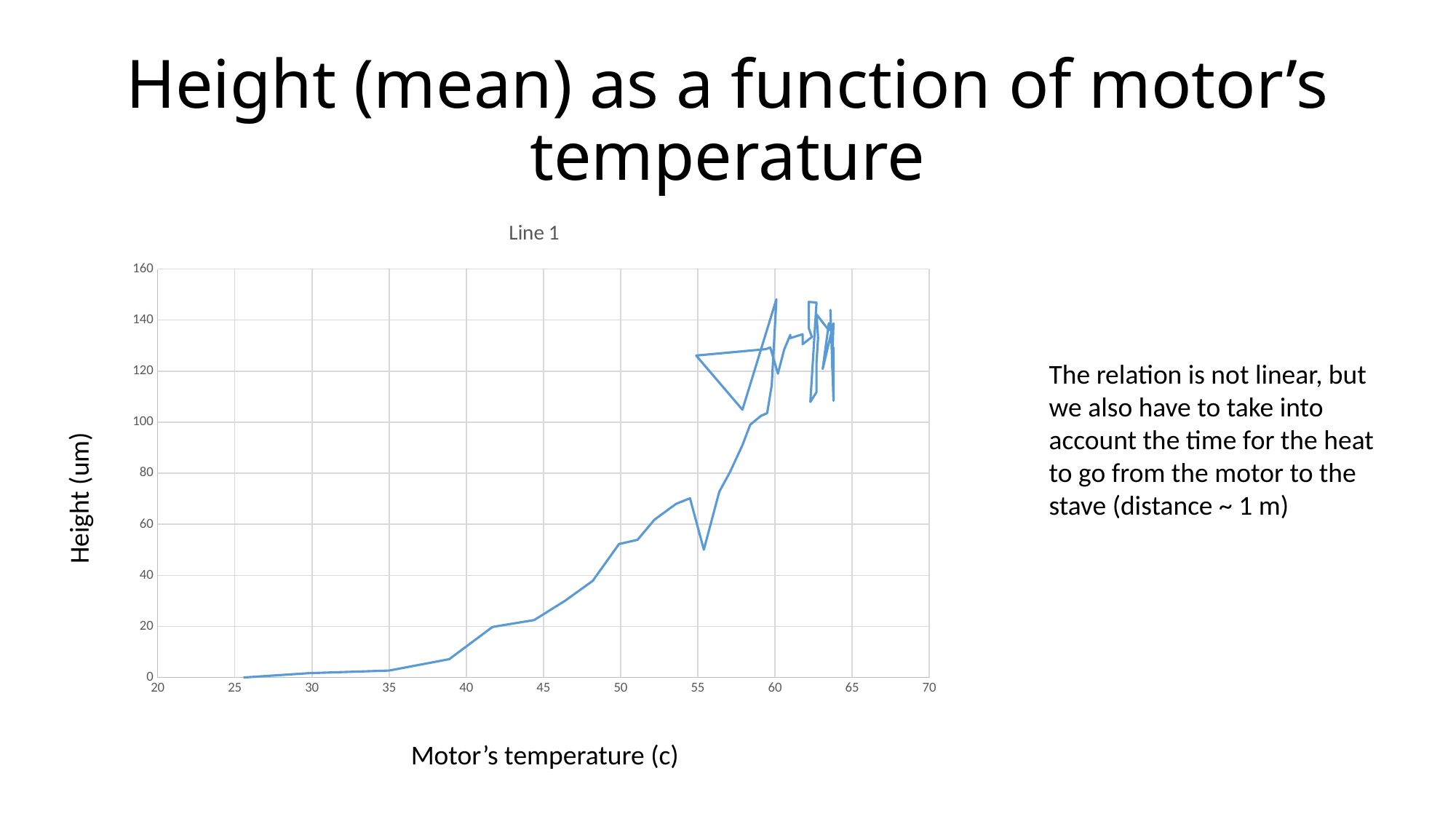
What is the title shown above the chart? Line 1 Is the height at a motor temperature of 30 greater or less than 20? less Is the height at a motor temperature of 45 greater or less than 40? less Is the height at a motor temperature of 50 greater or less than 40? greater Which is larger: the height at a motor temperature of 35 or the height at a motor temperature of 50? 50 What kind of chart is shown on the slide? line chart What is the label of the chart's y axis? Height (um) Overall, does the height rise or fall as the motor's temperature increases along the x axis? rise